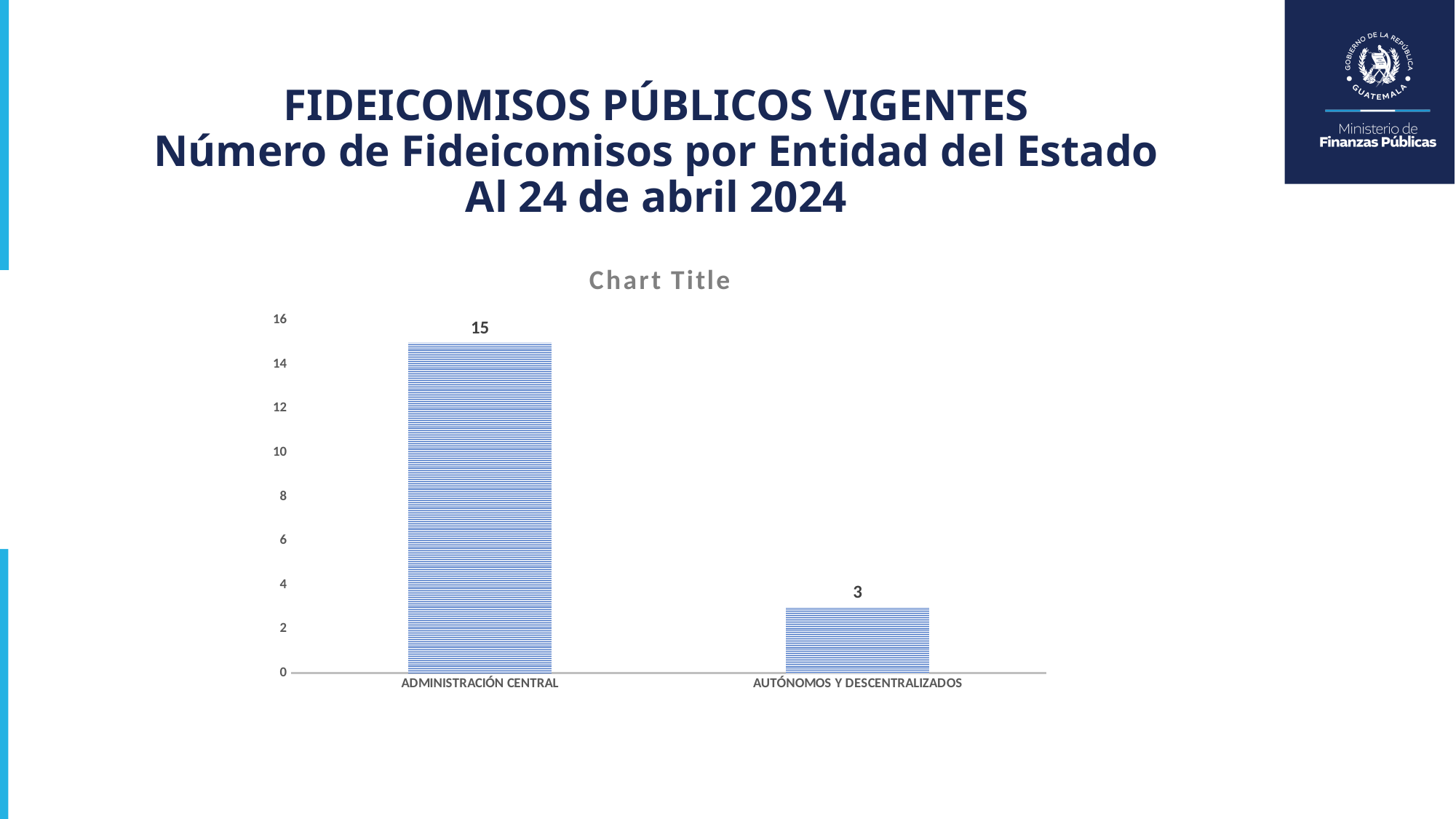
Which category has the highest value? ADMINISTRACIÓN CENTRAL Is the value for ADMINISTRACIÓN CENTRAL greater or less than 10? greater What is the value for AUTÓNOMOS Y DESCENTRALIZADOS? 3 What is the value for ADMINISTRACIÓN CENTRAL? 15 What kind of chart is shown on the slide? bar chart Is the value for AUTÓNOMOS Y DESCENTRALIZADOS greater or less than 4? less What is the title printed above the chart? Chart Title What is the difference between the values for ADMINISTRACIÓN CENTRAL and AUTÓNOMOS Y DESCENTRALIZADOS? 12 Which is larger, the value for ADMINISTRACIÓN CENTRAL or the value for AUTÓNOMOS Y DESCENTRALIZADOS? ADMINISTRACIÓN CENTRAL How many categories are shown on the chart? 2 Which category has the lowest value? AUTÓNOMOS Y DESCENTRALIZADOS What is the highest value shown on the vertical axis? 16